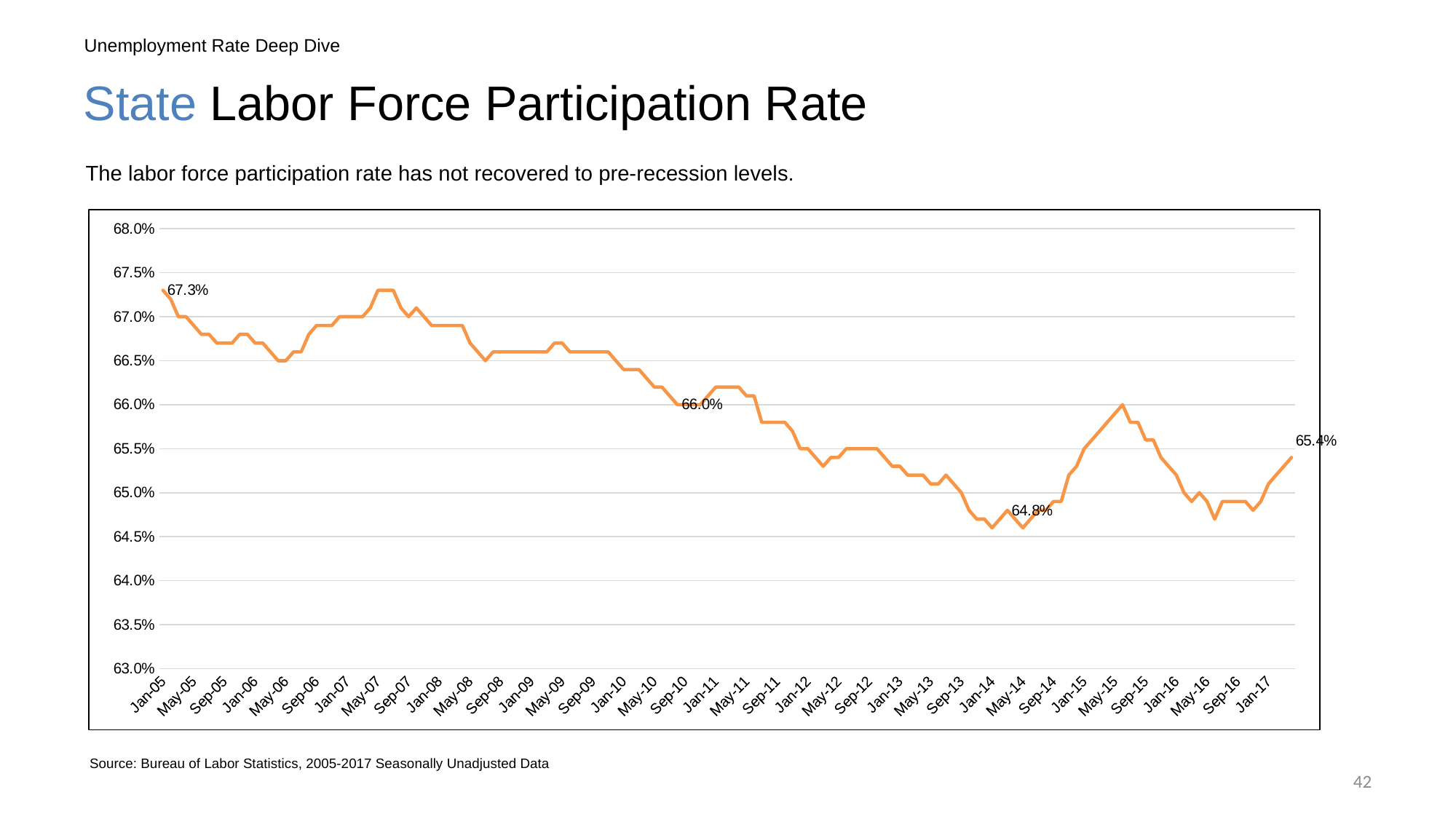
What source is cited for the chart data? Bureau of Labor Statistics, 2005-2017 Seasonally Unadjusted Data What value is labeled on the line near Sep-10? 66.0% By how many percentage points does the Jan-05 labeled value exceed the final labeled value of 65.4%? 1.9 percentage points Which is larger, the labeled value at Jan-05 or the labeled value at the end of the line? Jan-05 Is the value for Jan-14 greater or less than 65.0%? less What is the labor force participation rate labeled at Jan-05? 67.3% Is the value for May-15 greater or less than 65.5%? greater What is the value labeled at the final data point of the line? 65.4% What is the highest value labeled on the chart? 67.3% What kind of chart is shown on the slide? line chart What is the lowest value labeled on the chart? 64.8% Overall, does the labor force participation rate rise or fall from Jan-05 to the end of the series? fall